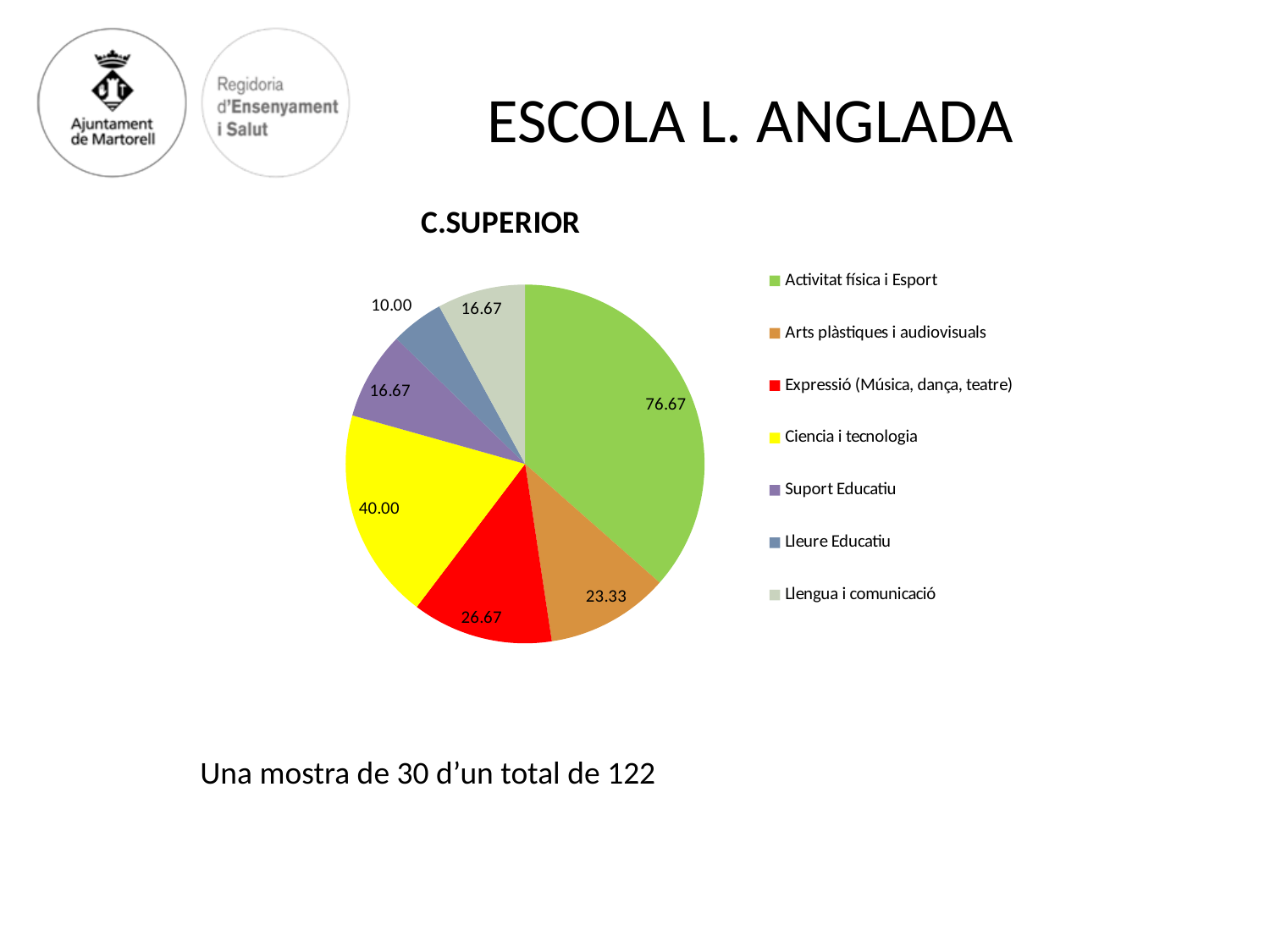
What is the value shown for Arts plàstiques i audiovisuals? 23.33 What is the value shown for Lleure Educatiu? 10.00 What is the difference between the values for Activitat física i Esport and Ciencia i tecnologia? 36.67 What colour is the slice for Ciencia i tecnologia? yellow What is the value shown for Activitat física i Esport? 76.67 How many slices does the pie chart have? 7 Which category has the smallest slice of the pie? Lleure Educatiu What is the title of the chart? C.SUPERIOR What type of chart is shown on the slide? pie chart What is the value shown for Ciencia i tecnologia? 40.00 Which is larger, the value for Ciencia i tecnologia or the value for Expressió (Música, dança, teatre)? Ciencia i tecnologia Which category has the largest slice of the pie? Activitat física i Esport